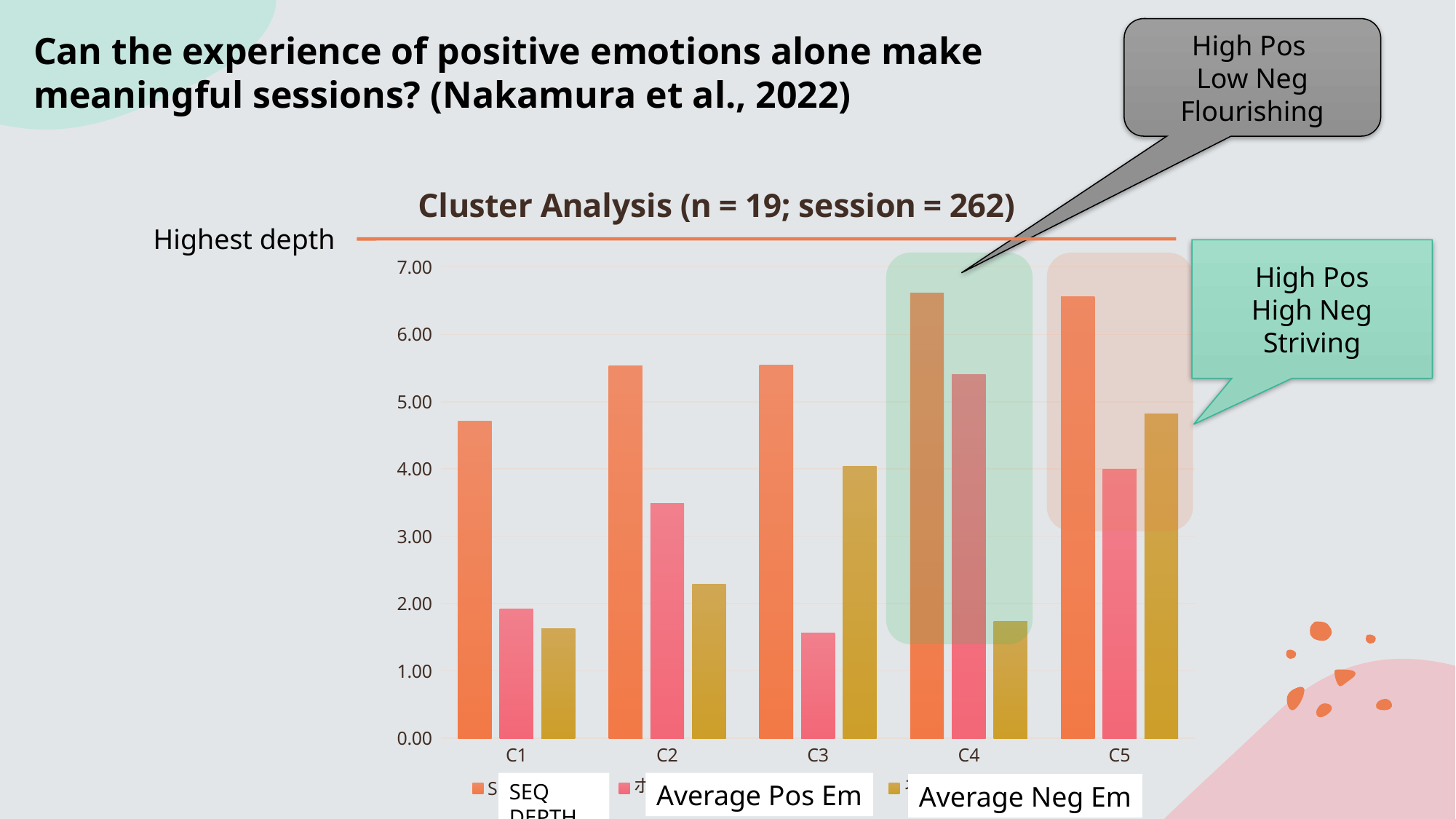
What is the title of the chart? Cluster Analysis (n = 19; session = 262) Is the SEQ DEPTH value for C1 greater or less than 5.00? less For cluster C3, which is larger: Average Pos Em or Average Neg Em? Average Neg Em For cluster C2, which is larger: Average Pos Em or Average Neg Em? Average Pos Em Which cluster has the highest Average Pos Em value? C4 How many clusters (categories) are shown on the x axis of the chart? 5 Which cluster has the lowest SEQ DEPTH value? C1 Which cluster has the highest Average Neg Em value? C5 Is the Average Pos Em value for C4 greater or less than 5.00? greater How many series does the chart's legend list? 3 What kind of chart is shown on the slide? bar chart Is the Average Pos Em value for C2 greater or less than 3.00? greater